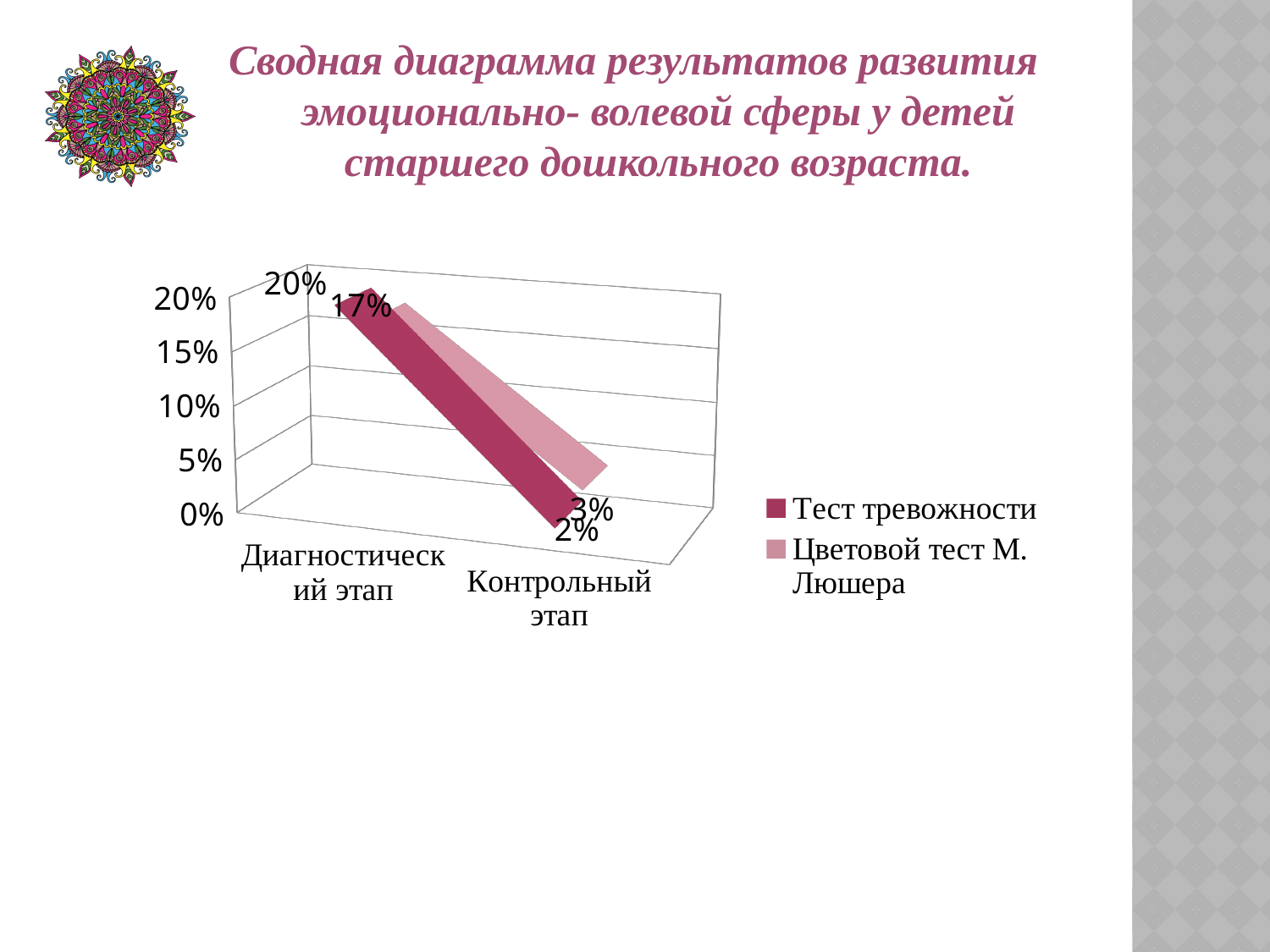
What kind of chart is shown on the slide? line chart By how much did the value for Тест тревожности decrease from the Диагностический этап to the Контрольный этап? 18% What are the two series listed in the legend? Тест тревожности and Цветовой тест М. Люшера By how much did the value for Цветовой тест М. Люшера decrease from the Диагностический этап to the Контрольный этап? 14% What is the value for Цветовой тест М. Люшера at the Диагностический этап? 17% What is the value for Тест тревожности at the Диагностический этап? 20% Which series has the higher value at the Диагностический этап? Тест тревожности How many series does the legend list? 2 What is the value for Цветовой тест М. Люшера at the Контрольный этап? 3% What is the value for Тест тревожности at the Контрольный этап? 2% Do the values for Тест тревожности rise or fall from the Диагностический этап to the Контрольный этап? fall How many categories are shown on the x axis? 2